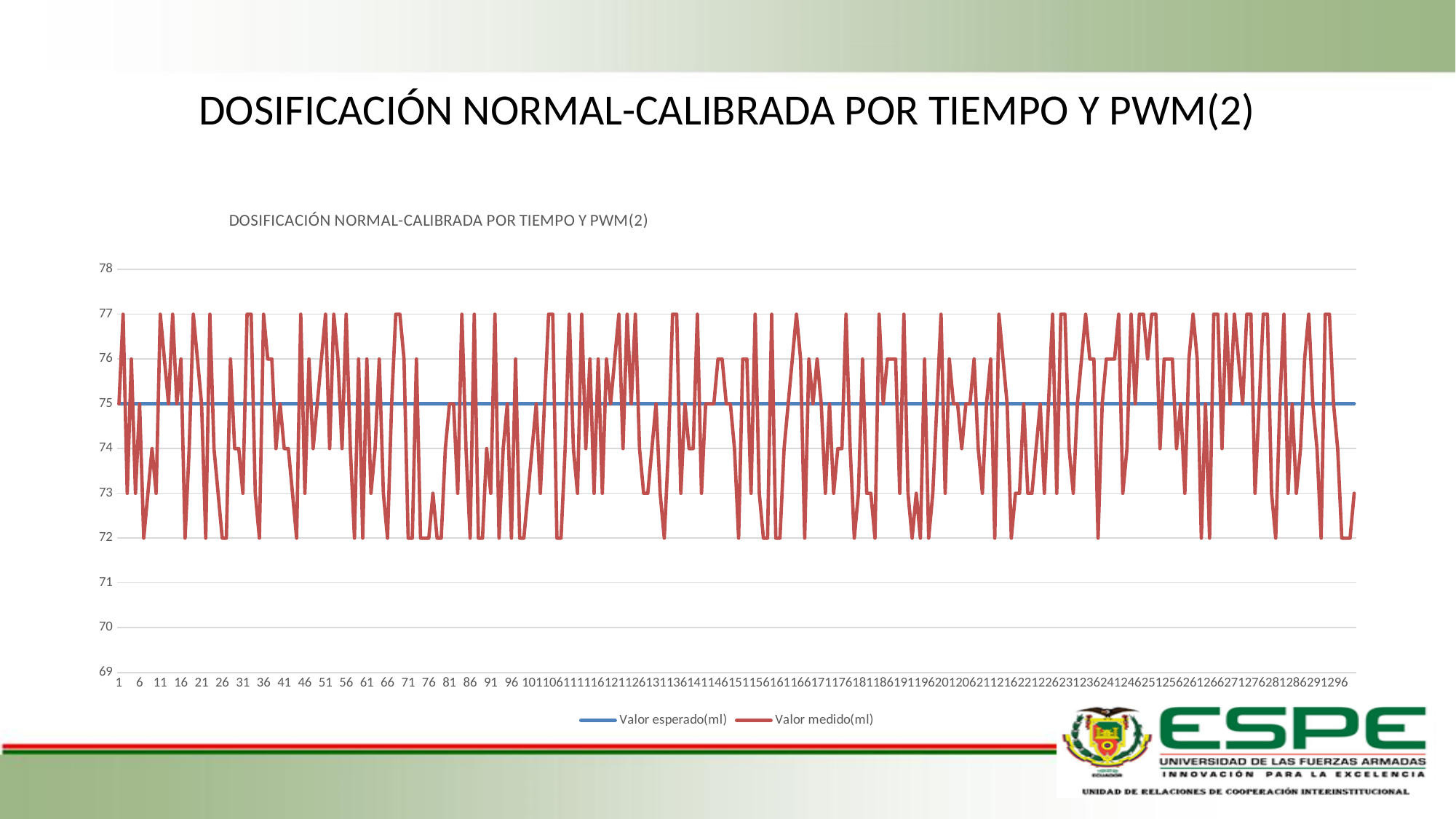
Does the Valor esperado(ml) line rise, fall, or stay flat across the x axis? Stays flat What is the title of the chart? DOSIFICACIÓN NORMAL-CALIBRADA POR TIEMPO Y PWM(2) How many series does the legend list? 2 What is the lowest value reached by the Valor medido(ml) series? 72 What is the difference between the highest Valor medido(ml) value and the Valor esperado(ml) value? 2 What are the two series named in the legend? Valor esperado(ml) and Valor medido(ml) What kind of chart is shown on the slide? Line chart Is the highest Valor medido(ml) value greater or less than 76? greater What constant value does the Valor esperado(ml) line sit at? 75 Is the lowest Valor medido(ml) value greater or less than 73? less What is the highest value reached by the Valor medido(ml) series? 77